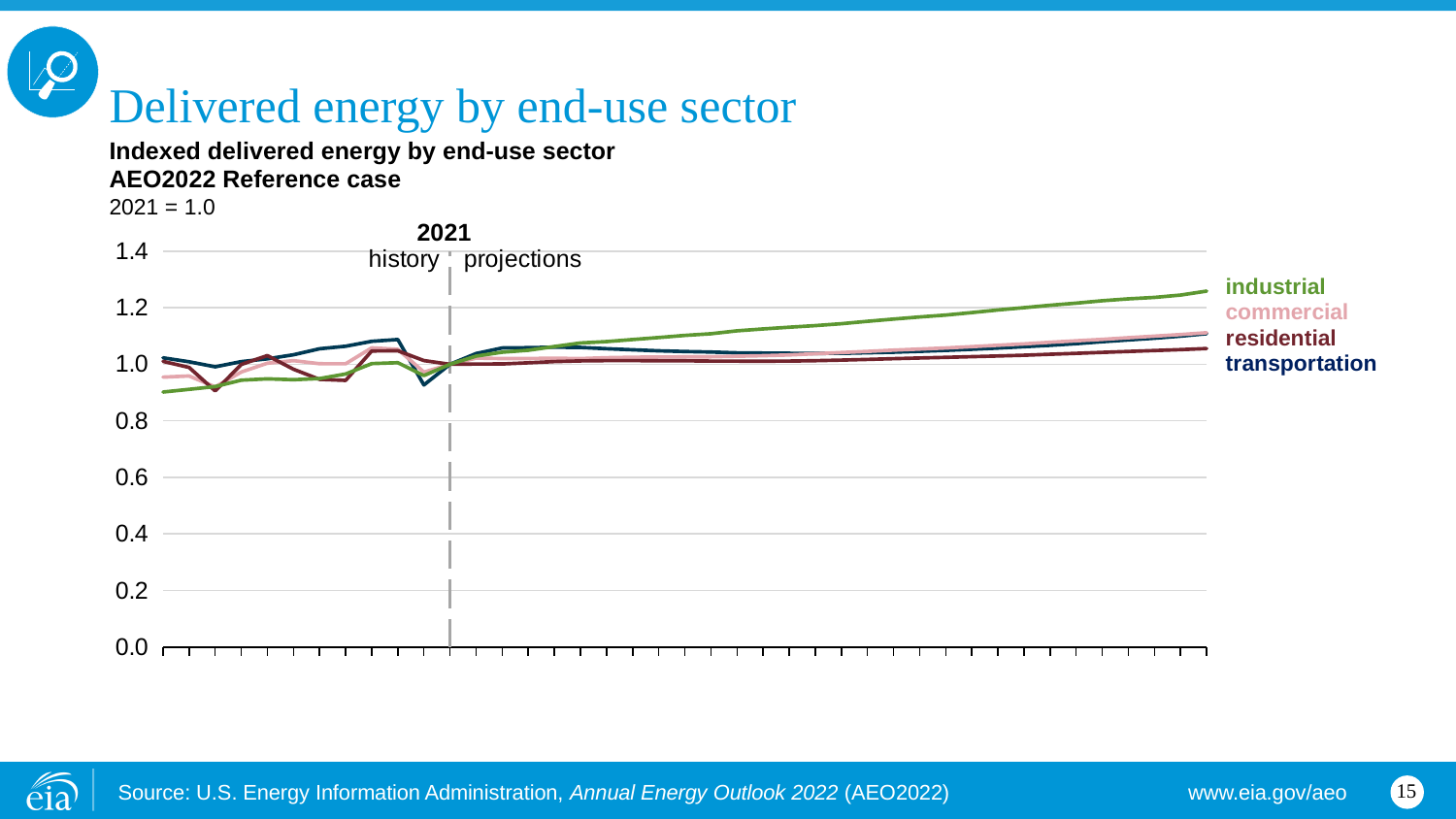
Does the industrial line rise or fall over the projection period? rise Which end-use sector has the highest indexed delivered energy at the end of the projection period? industrial At the end of the projection period, which is larger: industrial or transportation? industrial Which end-use sector has the lowest indexed delivered energy at the end of the projection period? residential At the end of the projection period, is the indexed value for transportation greater or less than 1.2? less How many series (end-use sectors) are plotted on the chart? 4 At the start of the history period, is the indexed value for industrial greater or less than 1.0? less Which year separates history from projections on the chart? 2021 At the end of the projection period, is the indexed value for industrial greater or less than 1.2? greater What kind of chart is shown on the slide? line chart What is the title of the chart? Indexed delivered energy by end-use sector, AEO2022 Reference case What is the indexed value of every sector in 2021, the base year? 1.0